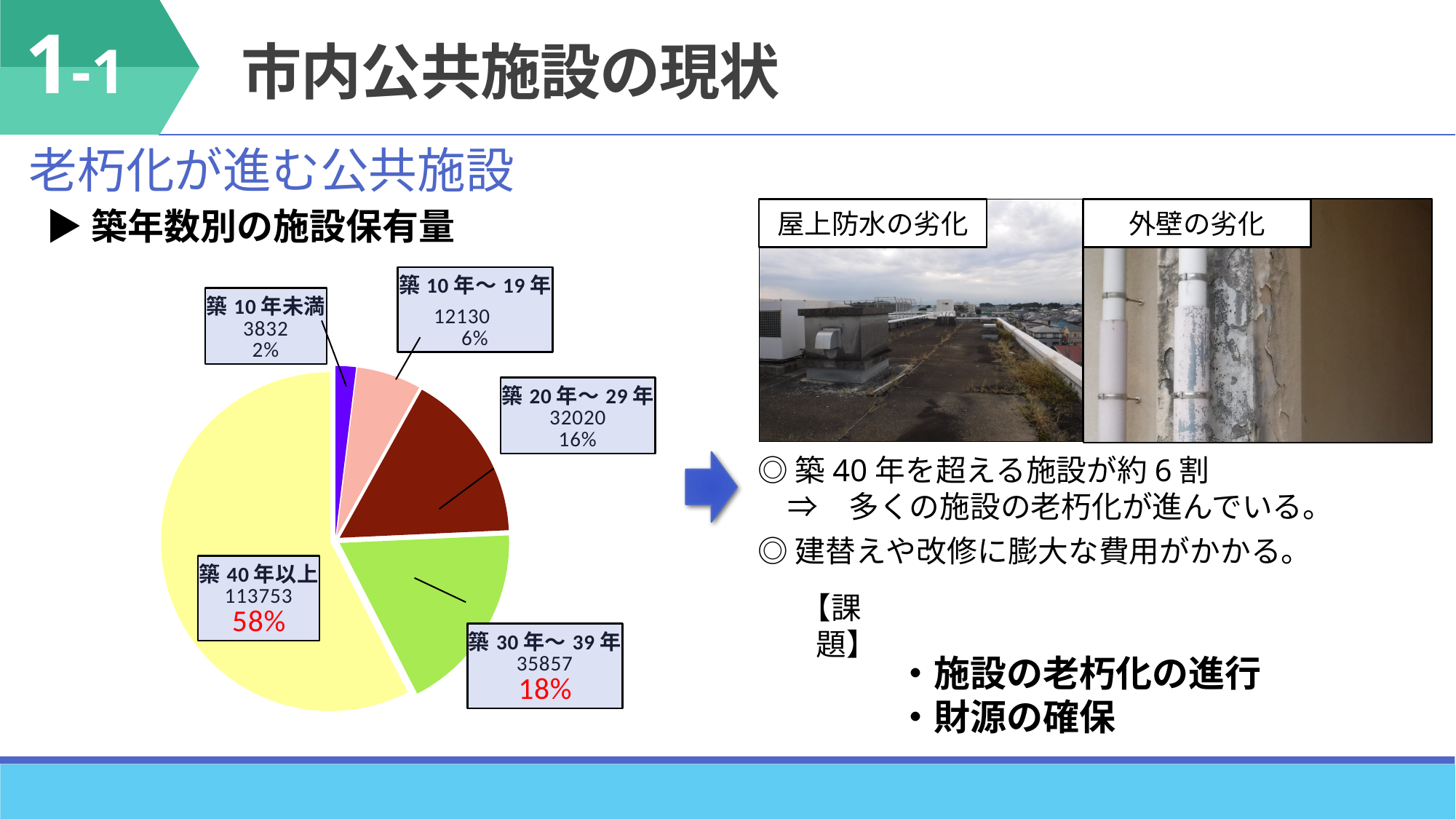
What share of the pie does 築10年未満 represent? 2% What is the value for 築30年～39年 in the pie chart? 35857 What is the difference between the values for 築30年～39年 and 築20年～29年? 3837 What share of the pie does 築20年～29年 represent? 16% What share of the pie does 築40年以上 represent? 58% Which category has the smallest slice in the pie chart? 築10年未満 What kind of chart is shown under 築年数別の施設保有量? Pie chart How many categories does the pie chart 築年数別の施設保有量 have? 5 What is the value for 築40年以上 in the pie chart? 113753 What is the value for 築10年～19年 in the pie chart? 12130 Which category has the largest slice in the pie chart? 築40年以上 Which is larger in the pie chart, 築20年～29年 or 築10年～19年? 築20年～29年